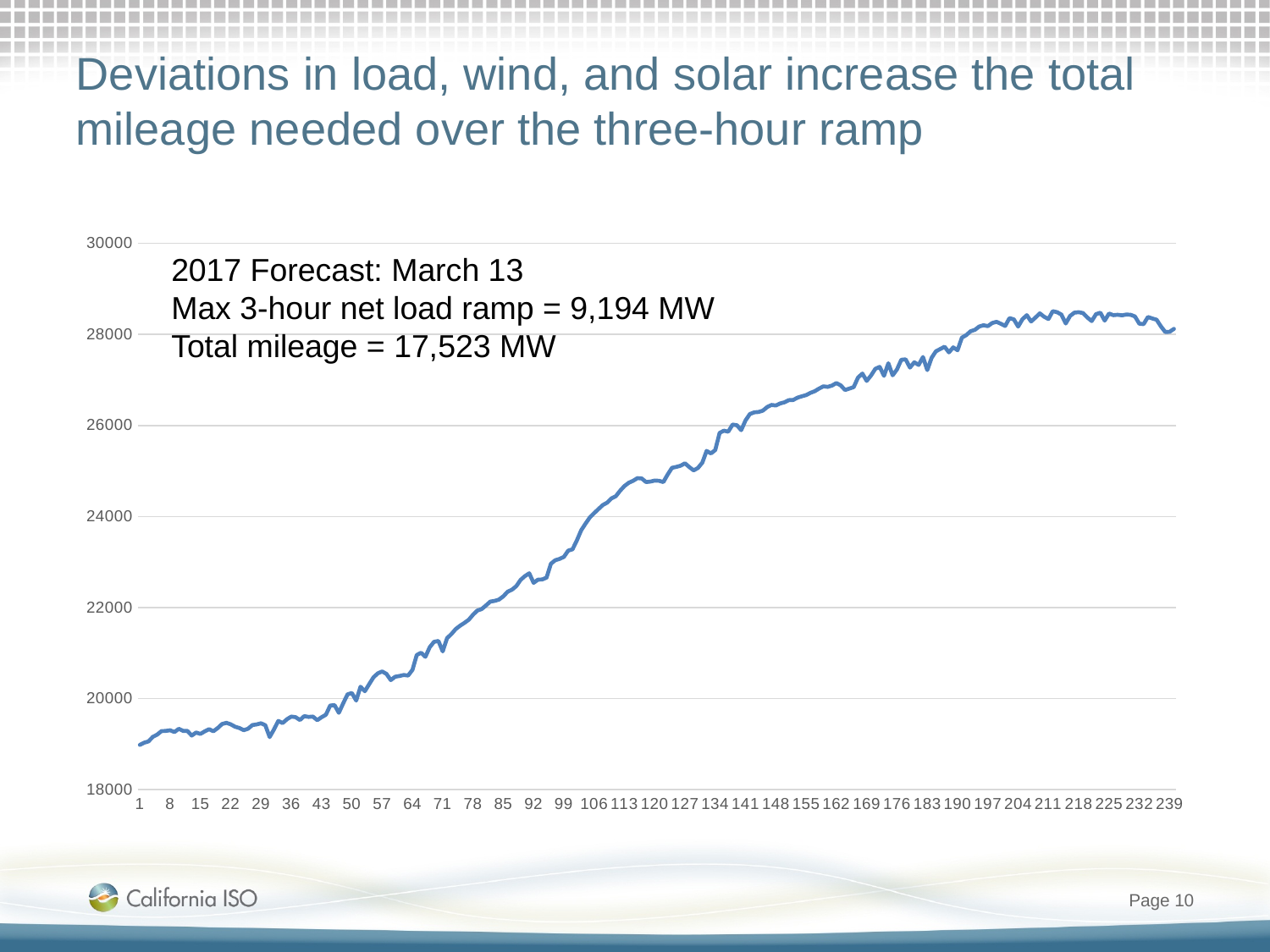
Is the value at x = 162 greater or less than 26000? greater Is the value at x = 120 greater or less than 24000? greater Is the value at x = 1 greater or less than 20000? less What kind of chart is shown on the slide? line chart According to the text on the chart, what is the total mileage? 17,523 MW Which is larger, the value at x = 36 or the value at x = 99? x = 99 Do the values generally rise or fall as you move from left to right along the x axis? rise According to the text on the chart, what is the max 3-hour net load ramp? 9,194 MW